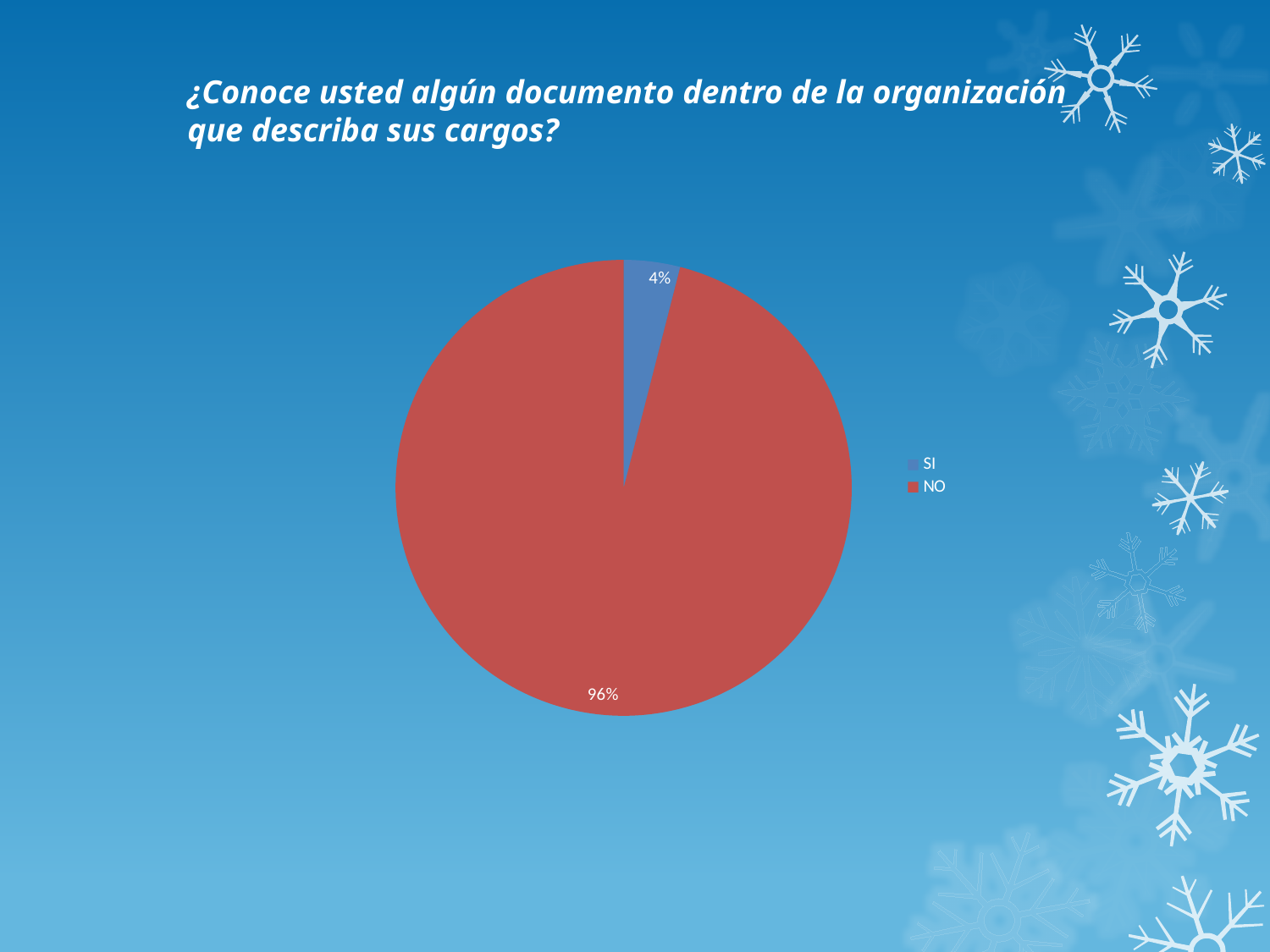
What percentage of the pie is labelled NO? 96% Which slice is larger, SI or NO? NO What colour is the SI slice? blue What is the difference in percentage points between the NO and SI slices? 92 Which category has the largest share of the pie? NO How many entries does the legend list? 2 How many slices does the pie chart have? 2 What percentage of the pie is labelled SI? 4% What colour is the NO slice? red What kind of chart is shown on the slide? pie chart Which category has the smallest share of the pie? SI What share of the pie does the NO slice represent? 96%